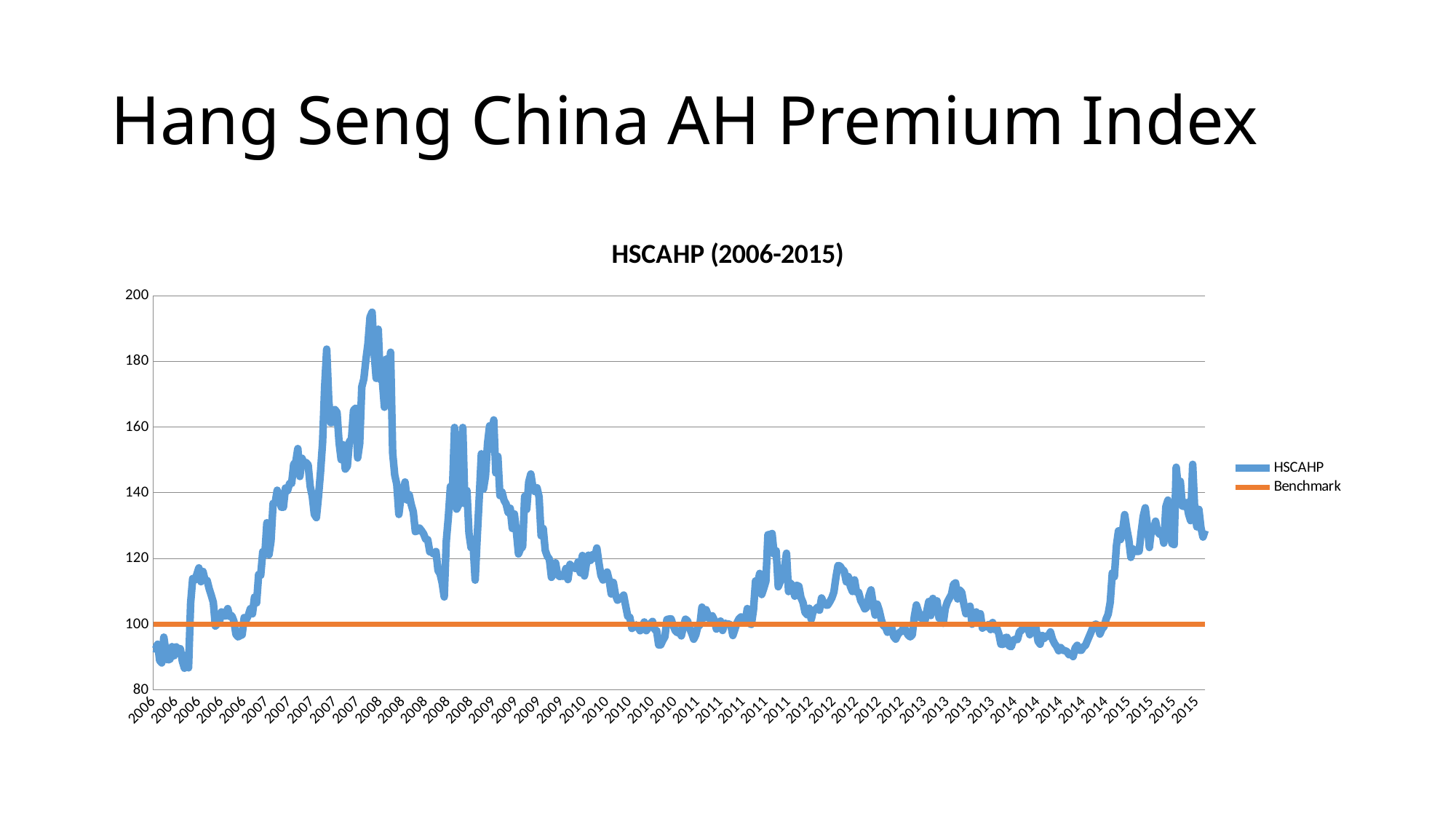
What is the title of the chart? HSCAHP (2006-2015) In which year does the HSCAHP series reach its highest value? 2008 How many series does the legend list? 2 Is the HSCAHP peak in 2015 greater or less than 140? greater Is the HSCAHP value at the end of 2015 greater or less than 120? greater Is the highest value of the HSCAHP series greater or less than 180? greater What value does the Benchmark line sit at? 100 What colour is the Benchmark line? orange Which is higher: the HSCAHP peak in 2008 or the HSCAHP peak in 2015? 2008 What kind of chart is shown on the slide? line chart Does the HSCAHP series rise or fall from its 2008 peak to 2010? fall